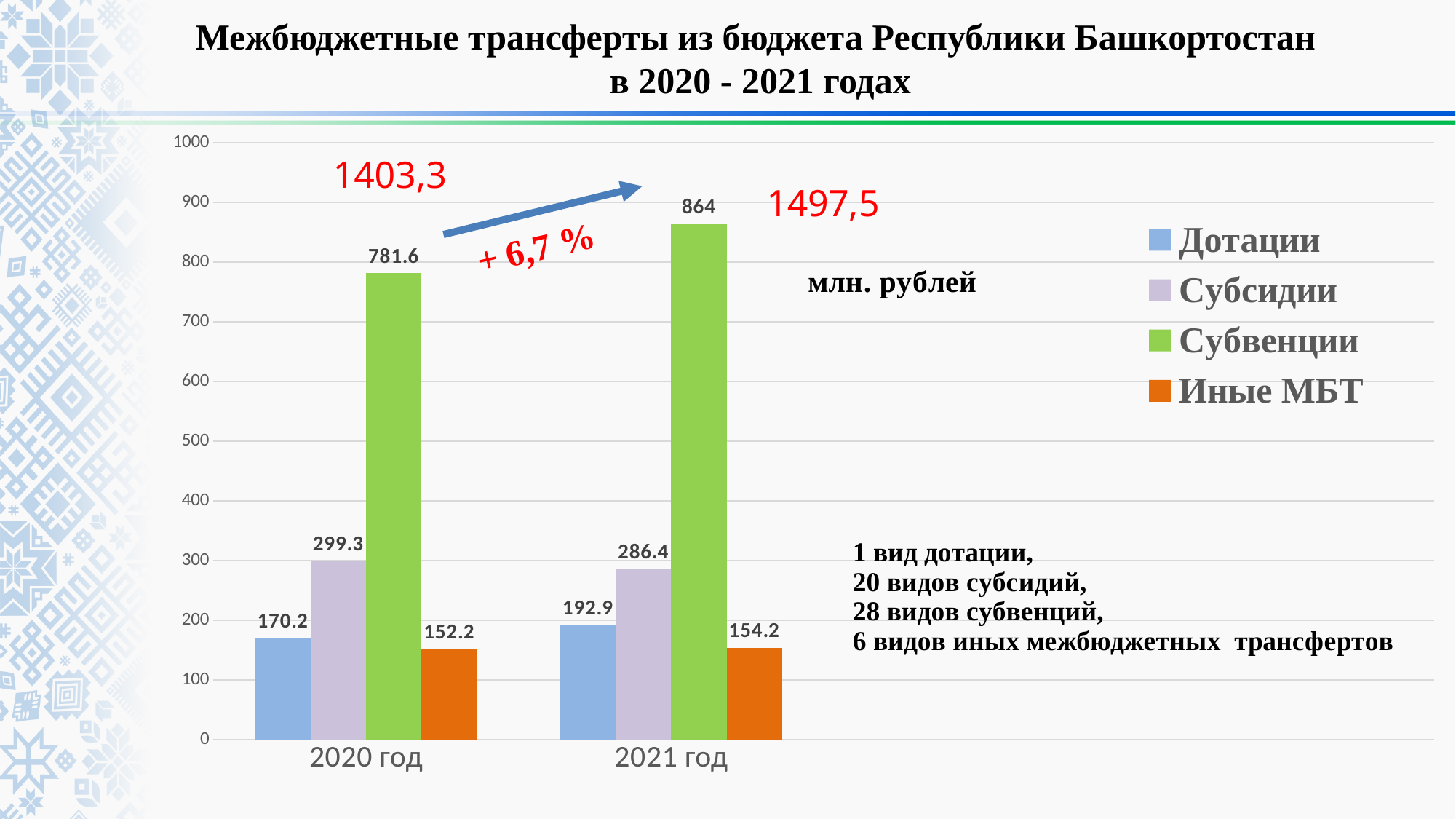
What is the value for Субсидии in 2021 год? 286.4 What kind of chart is shown on the slide? Bar chart Which series has the highest value in 2020 год? Субвенции Which is larger: Субсидии in 2020 год or Субсидии in 2021 год? Субсидии in 2020 год What is the difference between the Субвенции values for 2021 год and 2020 год? 82.4 Which colour represents Субвенции in the legend? Green What is the value for Дотации in 2020 год? 170.2 What is the value for Иные МБТ in 2020 год? 152.2 How many series does the legend list? 4 Which series has the lowest value in 2021 год? Иные МБТ What is the value for Субвенции in 2021 год? 864 How many year categories are shown on the x axis? 2